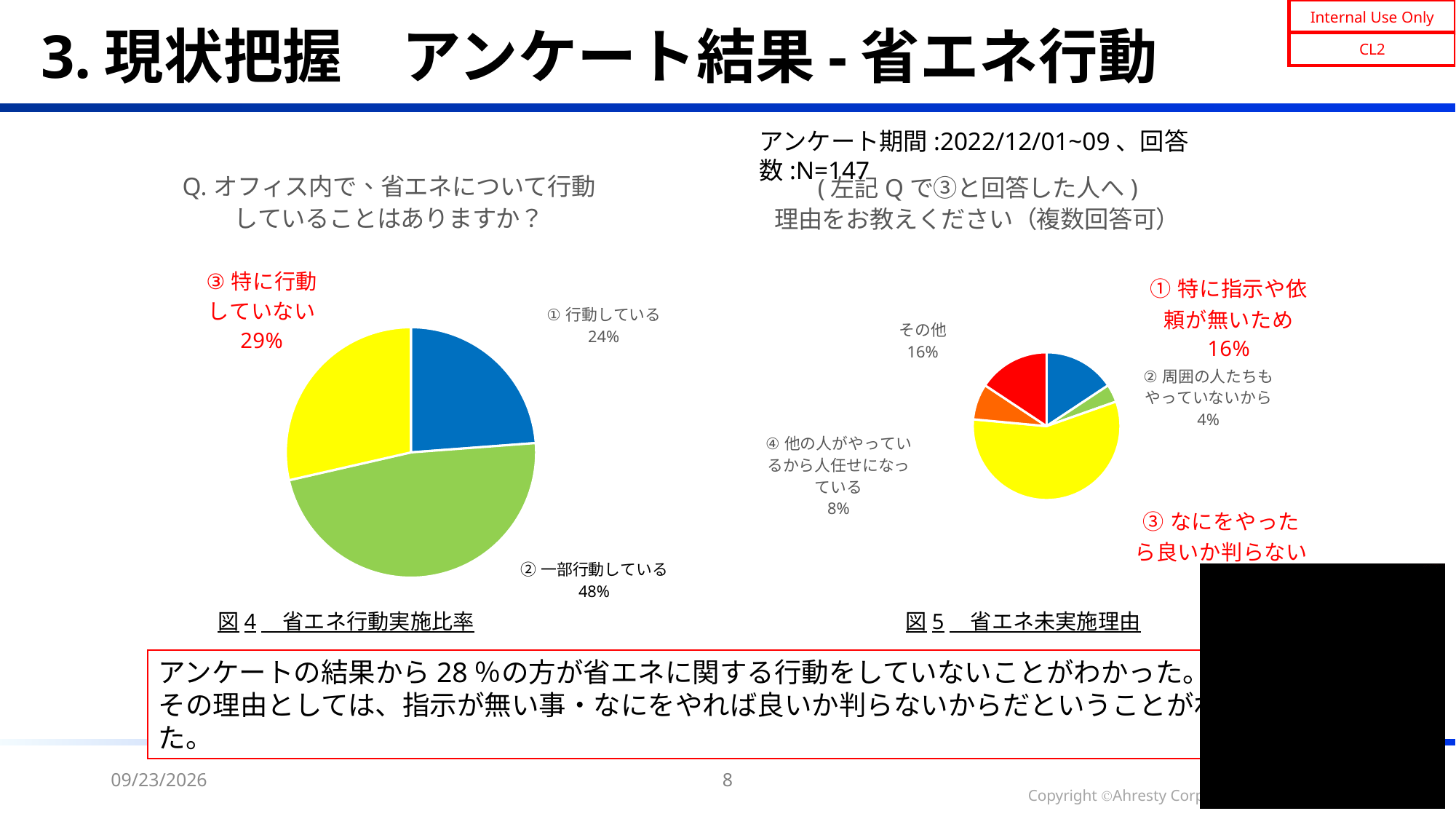
In the left pie chart (図4 省エネ行動実施比率), what percentage is shown for ③ 特に行動していない? 29% In the left pie chart (図4 省エネ行動実施比率), which category has the smallest share? ① 行動している In the right pie chart (図5 省エネ未実施理由), what percentage is shown for ④ 他の人がやっているから人任せになっている? 8% In the right pie chart (図5 省エネ未実施理由), which category has the largest share? ③ なにをやったら良いか判らない In the right pie chart (図5 省エネ未実施理由), which is larger: ① 特に指示や依頼が無いため or ④ 他の人がやっているから人任せになっている? ① 特に指示や依頼が無いため What type of chart is 図4 省エネ行動実施比率? Pie chart In the left pie chart (図4 省エネ行動実施比率), what percentage is shown for ② 一部行動している? 48% In the left pie chart (図4 省エネ行動実施比率), how many percentage points larger is ② 一部行動している than ① 行動している? 24 In the left pie chart (図4 省エネ行動実施比率), which category has the largest share? ② 一部行動している In the right pie chart (図5 省エネ未実施理由), what percentage is shown for ② 周囲の人たちもやっていないから? 4% In the left pie chart (図4 省エネ行動実施比率), what percentage is shown for ① 行動している? 24% How many slices does the left pie chart (図4 省エネ行動実施比率) have? 3